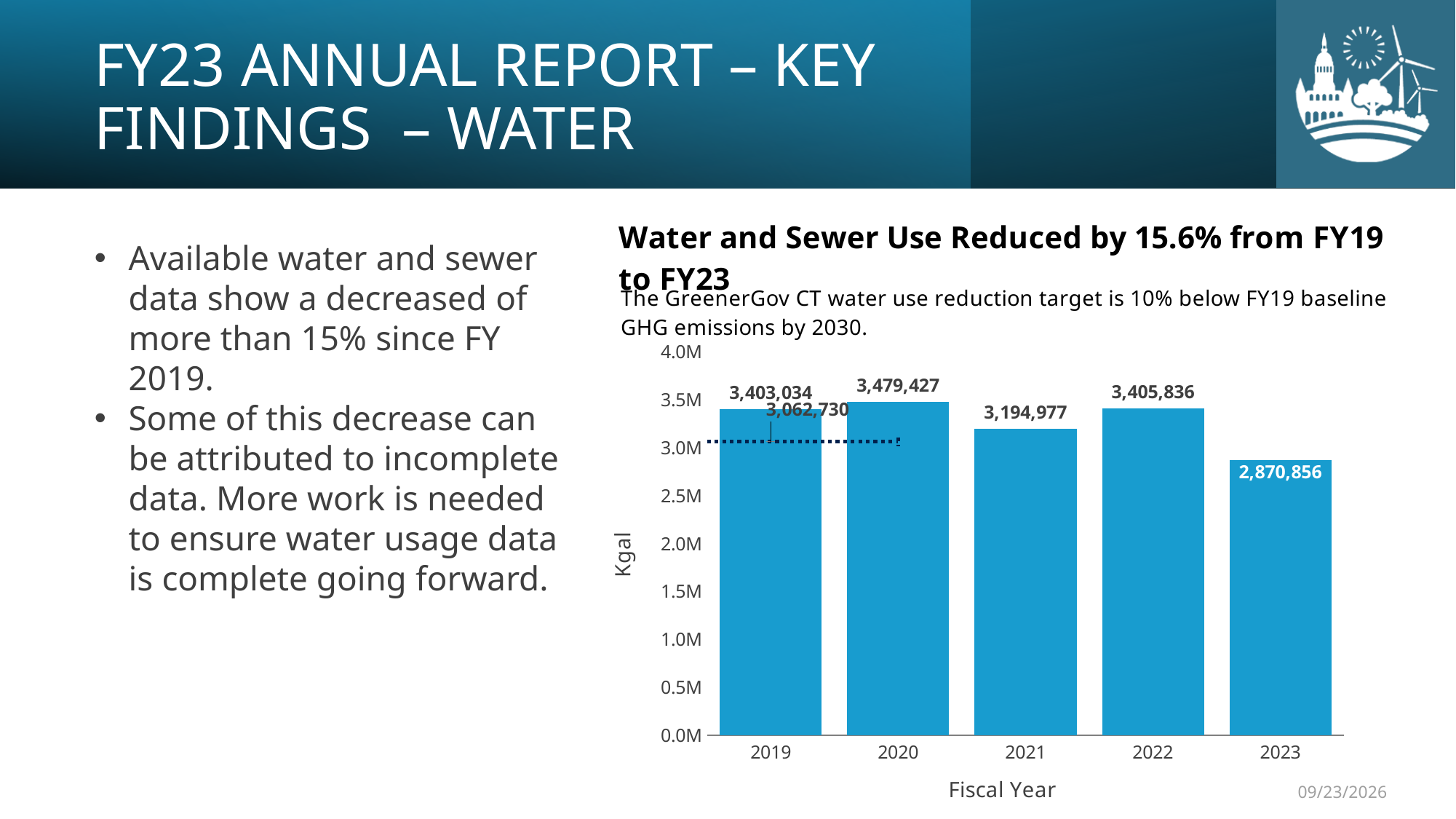
Is the value for 2023 greater or less than 3.0M? less What is the value for fiscal year 2021 in the chart? 3,194,977 What is the value for fiscal year 2020 in the chart? 3,479,427 What is the label of the y axis of the chart? Kgal What kind of chart is shown on the slide? bar chart How many fiscal years are shown on the x axis of the chart? 5 Which fiscal year has the lowest value in the chart? 2023 What is the difference between the values for 2019 and 2023? 532,178 Which fiscal year has the larger value, 2021 or 2022? 2022 What is the value for fiscal year 2023 in the chart? 2,870,856 Which fiscal year has the highest value in the chart? 2020 What is the difference between the values for 2020 and 2023? 608,571